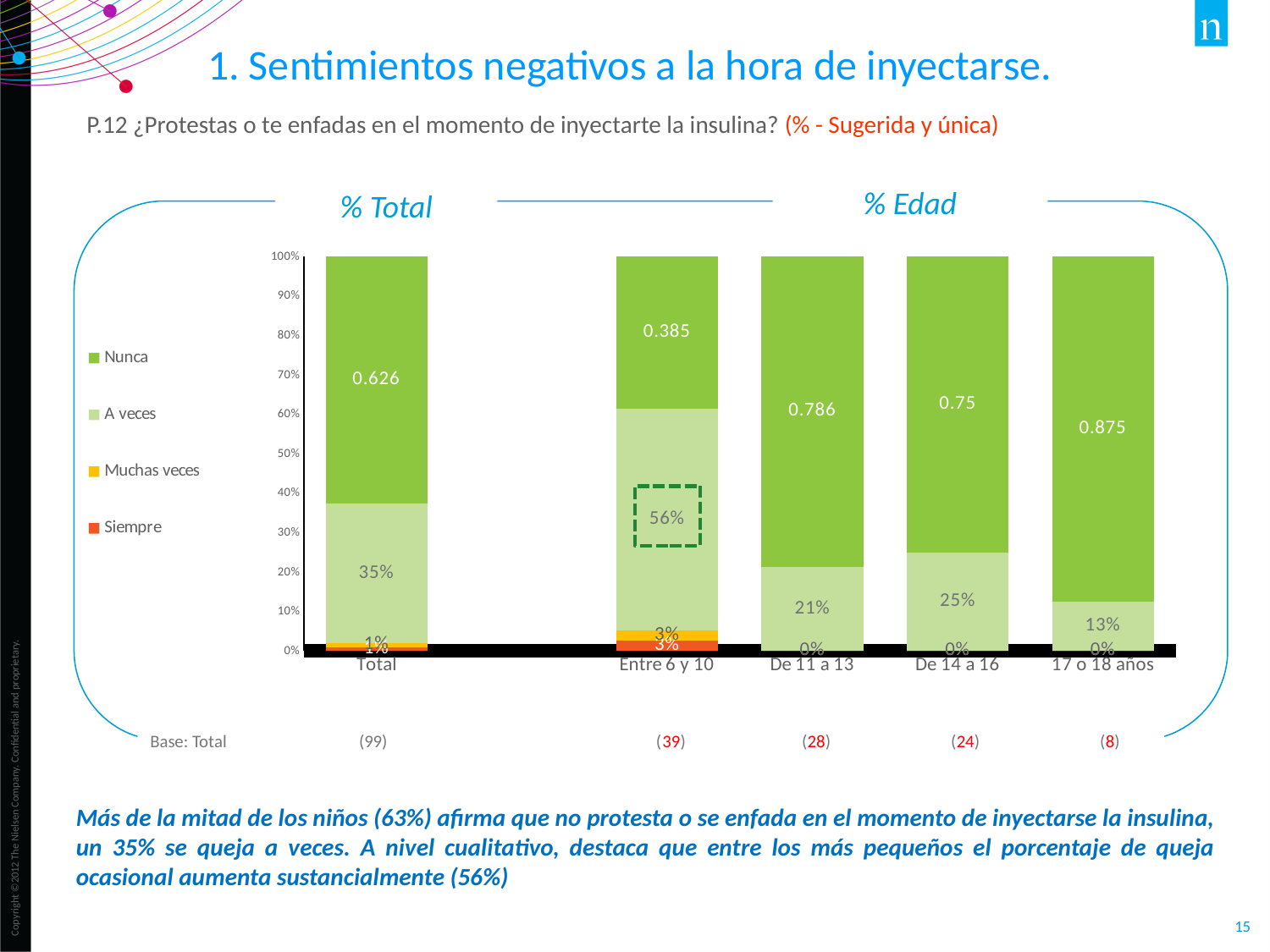
What is the base (number of respondents) shown for the Entre 6 y 10 category? 39 Which category has the highest Nunca value? 17 o 18 años What is the difference between the A veces value for Total and the A veces value for 17 o 18 años? 22% What kind of chart is shown on the slide? Stacked bar chart Which has the larger A veces value, De 11 a 13 or De 14 a 16? De 14 a 16 How many categories are shown along the x axis? 5 What is the value of the Nunca segment for 17 o 18 años? 0.875 Which category has the lowest Nunca value? Entre 6 y 10 How many series does the legend list? 4 What is the value of the A veces segment for Entre 6 y 10? 56% What is the value of the A veces segment for De 11 a 13? 21% What is the value of the Nunca segment for the Total category? 0.626